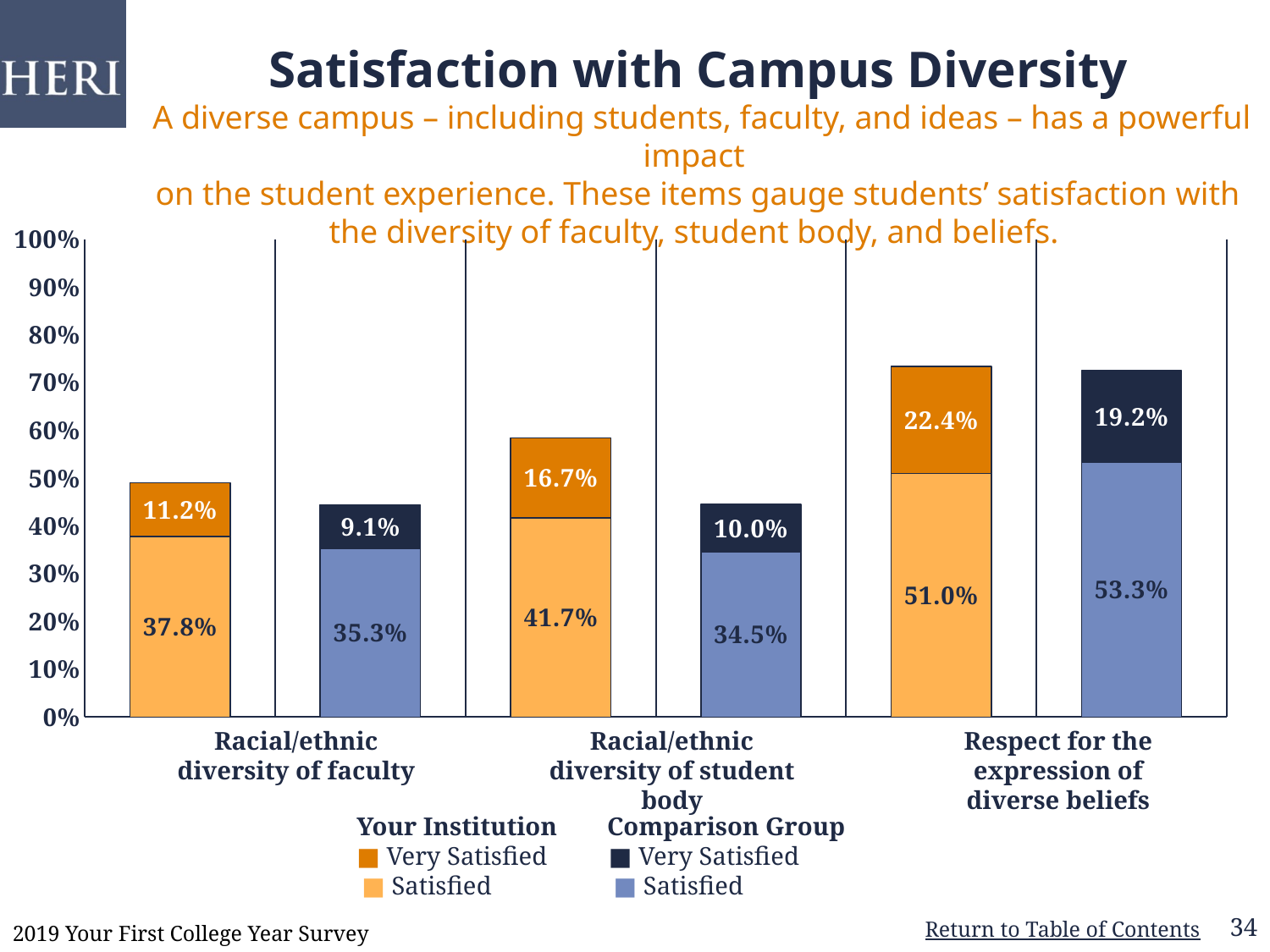
What is the total (Satisfied plus Very Satisfied) for Your Institution on racial/ethnic diversity of student body? 58.4% What percentage of Your Institution students were Satisfied with respect for the expression of diverse beliefs? 51.0% What is the total (Satisfied plus Very Satisfied) for the Comparison Group on racial/ethnic diversity of faculty? 44.4% How many categories are shown on the x axis of the chart? 3 What kind of chart is shown on the slide? Stacked bar chart Which category has the highest Very Satisfied percentage for Your Institution? Respect for the expression of diverse beliefs What percentage of Comparison Group students were Satisfied with racial/ethnic diversity of student body? 34.5% Which category has the lowest Very Satisfied percentage for the Comparison Group? Racial/ethnic diversity of faculty What percentage of Your Institution students were Very Satisfied with racial/ethnic diversity of faculty? 11.2% What is the difference between the Your Institution and Comparison Group Very Satisfied percentages for racial/ethnic diversity of student body? 6.7% Which is larger: the Satisfied percentage for Your Institution or for the Comparison Group on respect for the expression of diverse beliefs? Comparison Group What percentage of Comparison Group students were Very Satisfied with respect for the expression of diverse beliefs? 19.2%